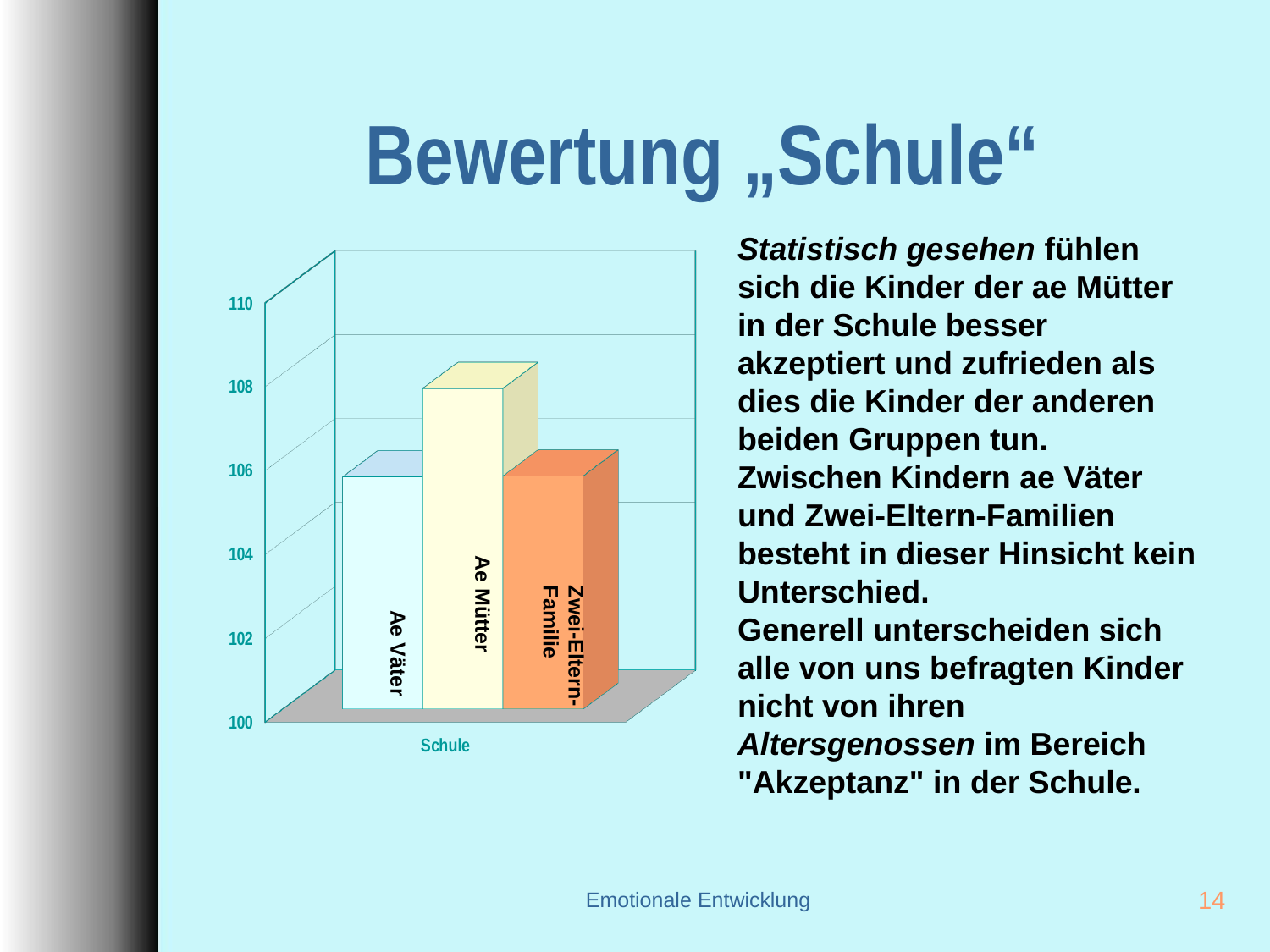
Is the value for Zwei-Eltern-Familie greater or less than 108? less What is the lowest value shown on the vertical axis of the chart? 100 What label appears below the bars on the horizontal axis? Schule Which category has the highest bar in the chart? Ae Mütter Which is larger, the value for Ae Mütter or the value for Ae Väter? Ae Mütter Is the value for Zwei-Eltern-Familie greater or less than 104? greater How many bars (categories) does the chart show? 3 What kind of chart is shown on the slide? bar chart Is the value for Ae Mütter greater or less than 110? less